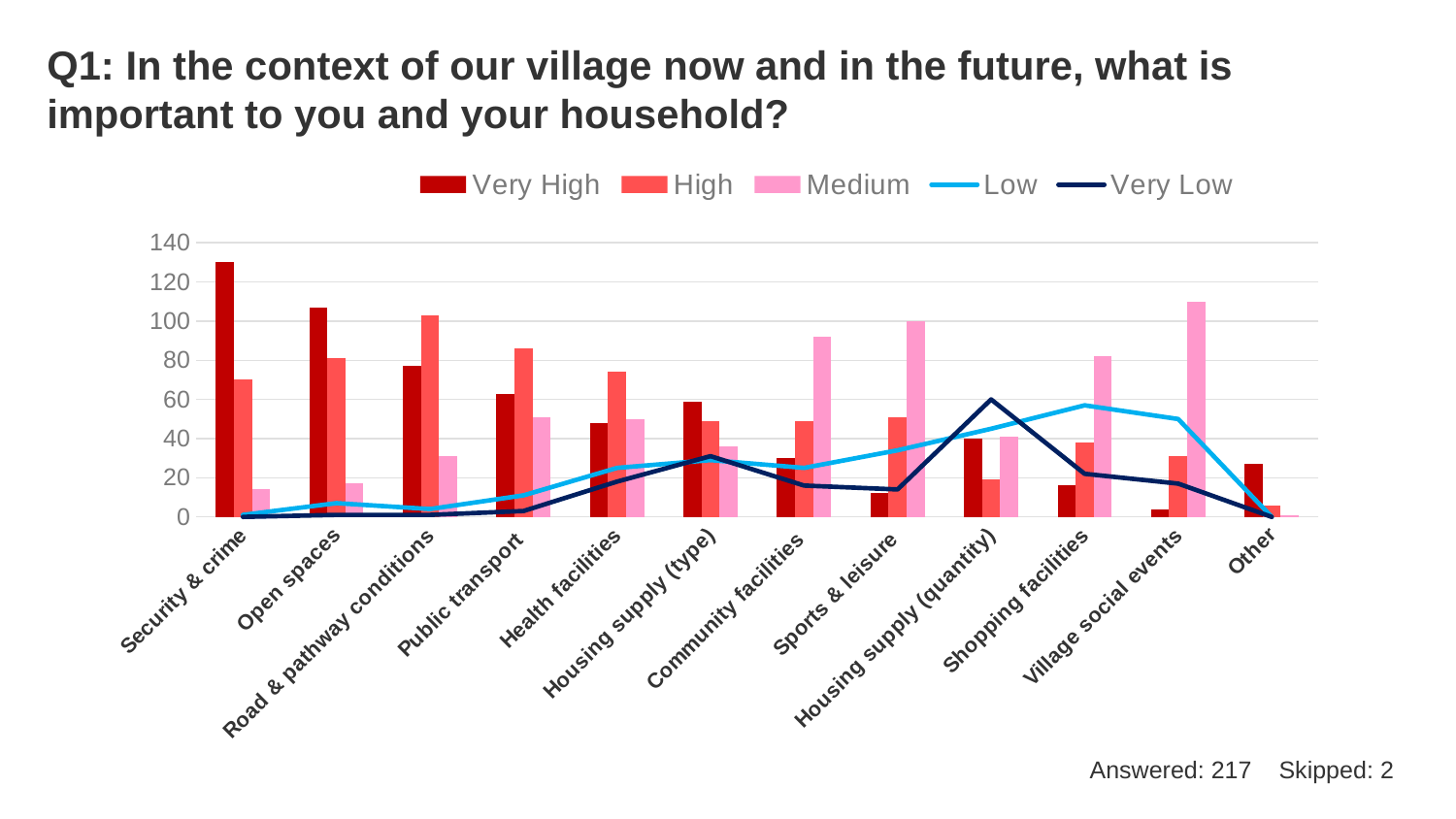
Is the High value for Road & pathway conditions greater or less than 80? greater Which series is shown in the legend as a light blue line? Low Which category has the highest Medium value? Village social events Which category has the highest Very Low value? Housing supply (quantity) For Village social events, which is larger, the Medium value or the Very High value? Medium How many series does the legend list? 5 Is the Very High value for Other greater or less than 40? less Which is larger, the Very High value for Security & crime or the Very High value for Open spaces? Security & crime How many categories are shown along the x axis? 12 Is the Very High value for Security & crime greater or less than 120? greater What kind of chart is shown on the slide? A combined bar and line chart Which category has the highest Very High value? Security & crime